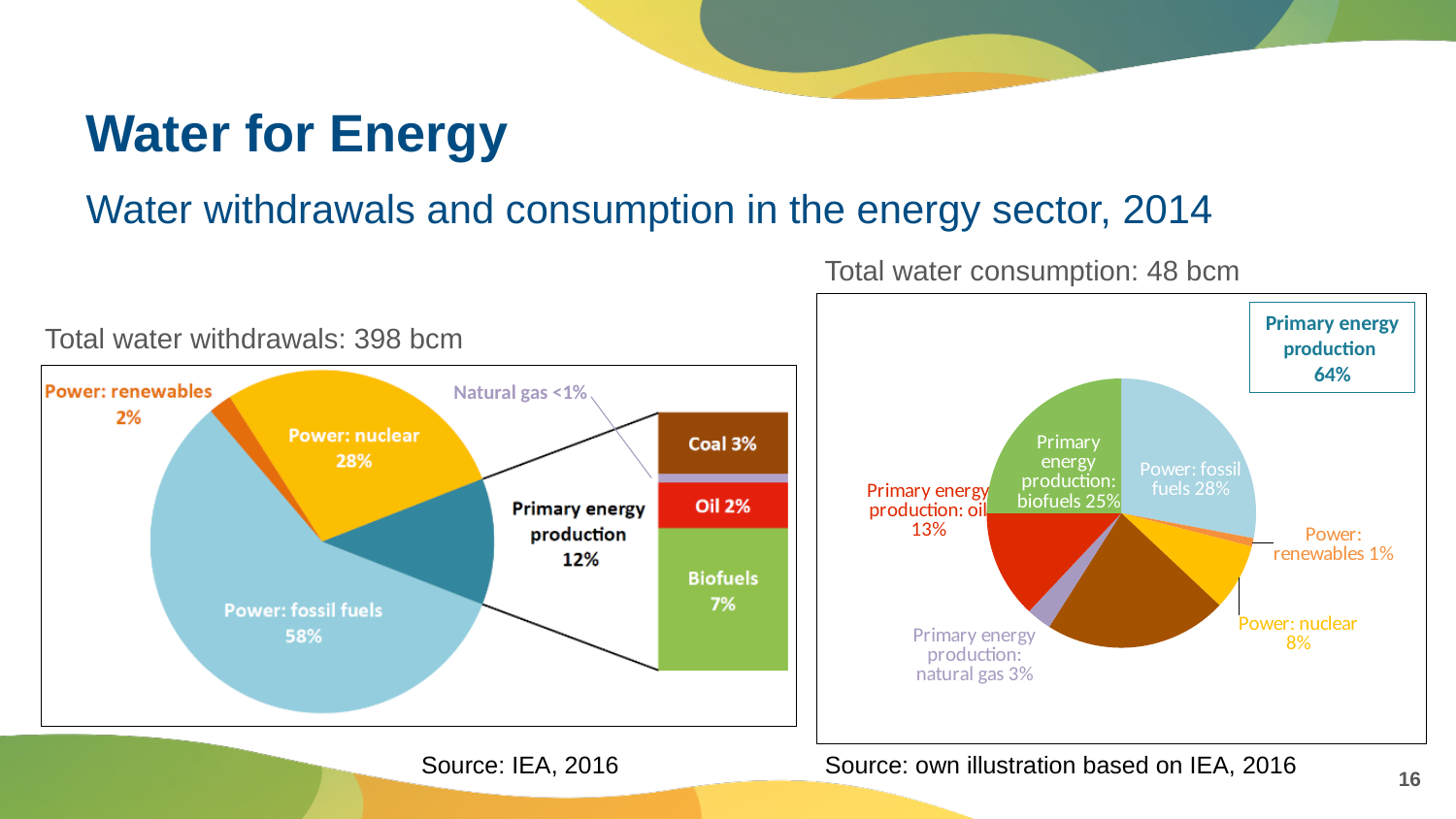
What type of chart is used for 'Total water consumption: 48 bcm'? Pie chart In the 'Total water withdrawals: 398 bcm' chart, what share is Primary energy production? 12% In the 'Total water consumption: 48 bcm' chart, what share is Power: nuclear? 8% In the 'Total water consumption: 48 bcm' chart, which is larger: Power: fossil fuels or Primary energy production: biofuels? Power: fossil fuels In the 'Total water consumption: 48 bcm' chart, what share is Primary energy production: biofuels? 25% In the 'Total water withdrawals: 398 bcm' chart, what share is Power: fossil fuels? 58% In the 'Total water consumption: 48 bcm' chart, which slice is the smallest? Power: renewables In the 'Total water consumption: 48 bcm' chart, what share is Primary energy production: oil? 13% In the 'Total water withdrawals: 398 bcm' chart, what share of the Primary energy production breakdown is Biofuels? 7% In the 'Total water withdrawals: 398 bcm' chart, which slice is the largest? Power: fossil fuels In the 'Total water withdrawals: 398 bcm' chart, what is the difference between Power: fossil fuels and Power: nuclear? 30 percentage points In the 'Total water withdrawals: 398 bcm' chart, what share is Power: nuclear? 28%